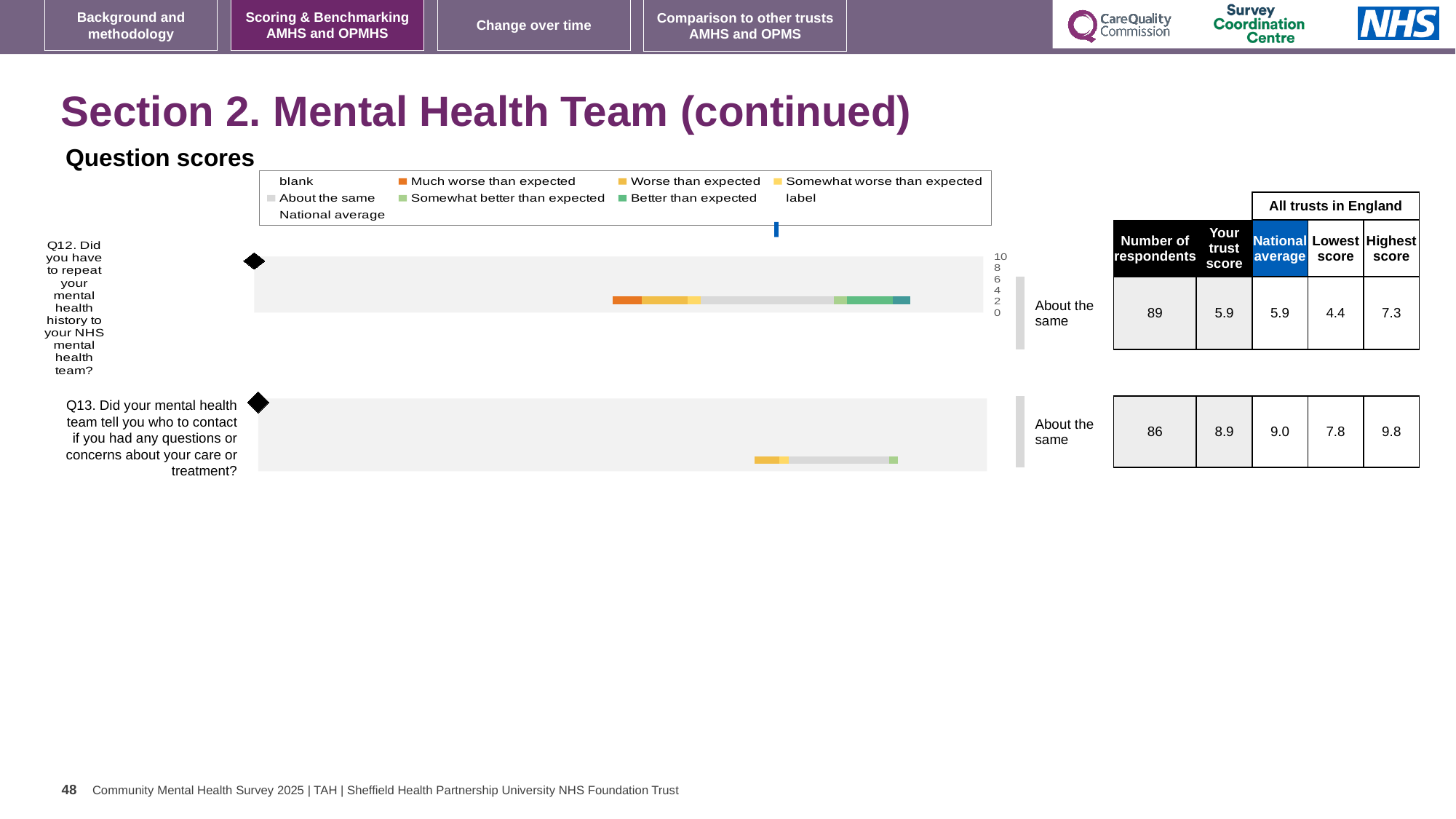
What is the lowest score across all trusts in England for Q13? 7.8 What is the difference between the highest and lowest scores for Q12? 2.9 Which question has more respondents, Q12 or Q13? Q12 In the chart legend, which colour represents 'Much worse than expected'? orange What is the number of respondents for Q12? 89 What benchmark category is shown next to the Q12 chart? About the same What kind of chart is used to show the expected range for Q12? bar chart What is the highest score across all trusts in England for Q12? 7.3 What is the national average for Q13 (told who to contact)? 9.0 How many questions (Q12 and Q13) have charts on this slide? 2 What is the trust score for Q12 (repeating mental health history)? 5.9 For Q13, which is larger: the trust score or the national average? national average